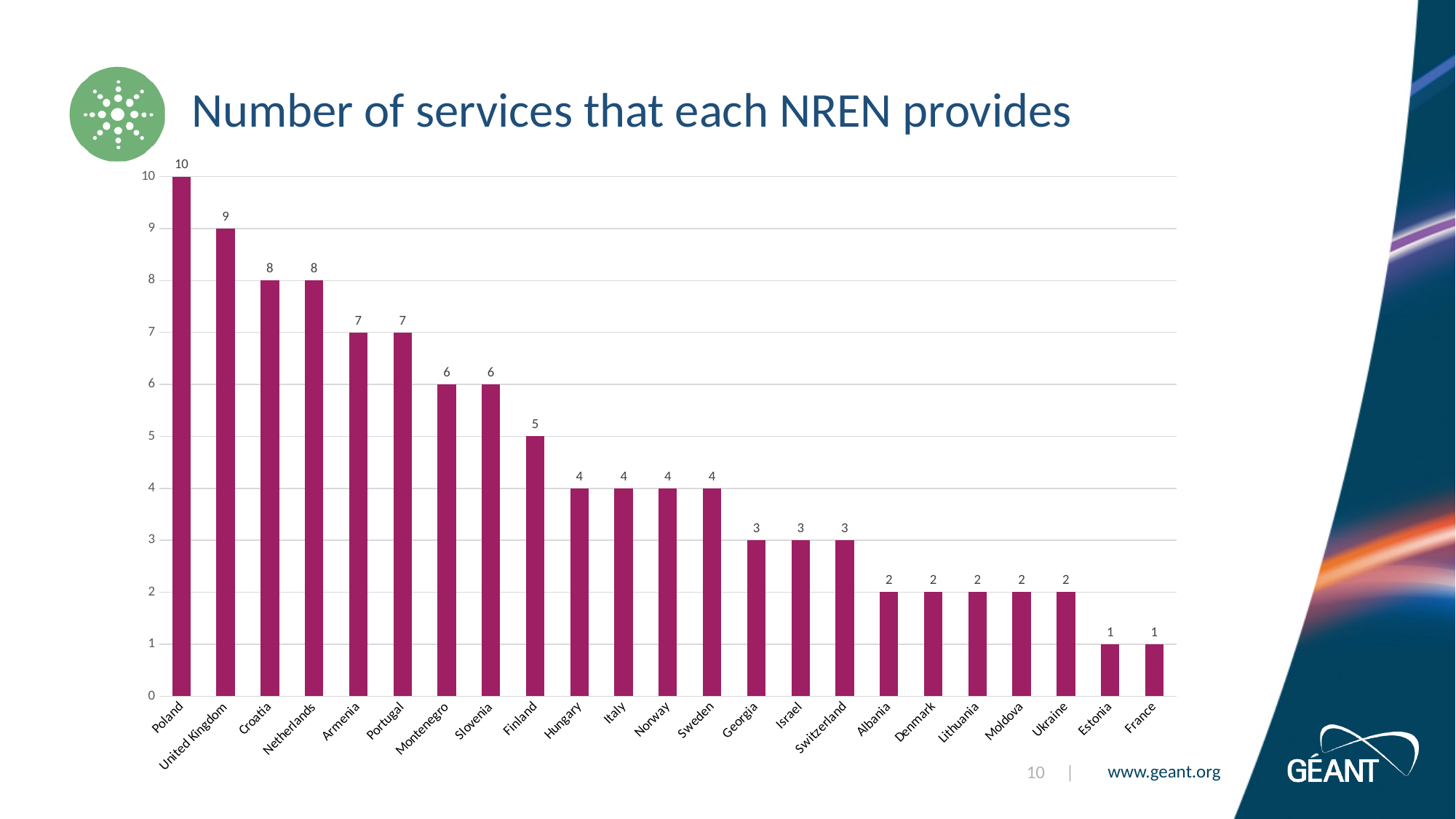
What is the value shown for Switzerland? 3 What is the title of the chart? Number of services that each NREN provides How many services does Poland provide according to the chart? 10 How many countries are shown on the x axis of the chart? 23 What is the value shown for the United Kingdom? 9 Which has a larger value, Montenegro or Georgia? Montenegro What type of chart is shown on the slide? bar chart Which country has the highest number of services in the chart? Poland What is the difference between the values for Armenia and Hungary? 3 How many services does Finland provide? 5 What is the difference between the values for Poland and Croatia? 2 Do the values rise or fall moving from left to right along the x axis? fall